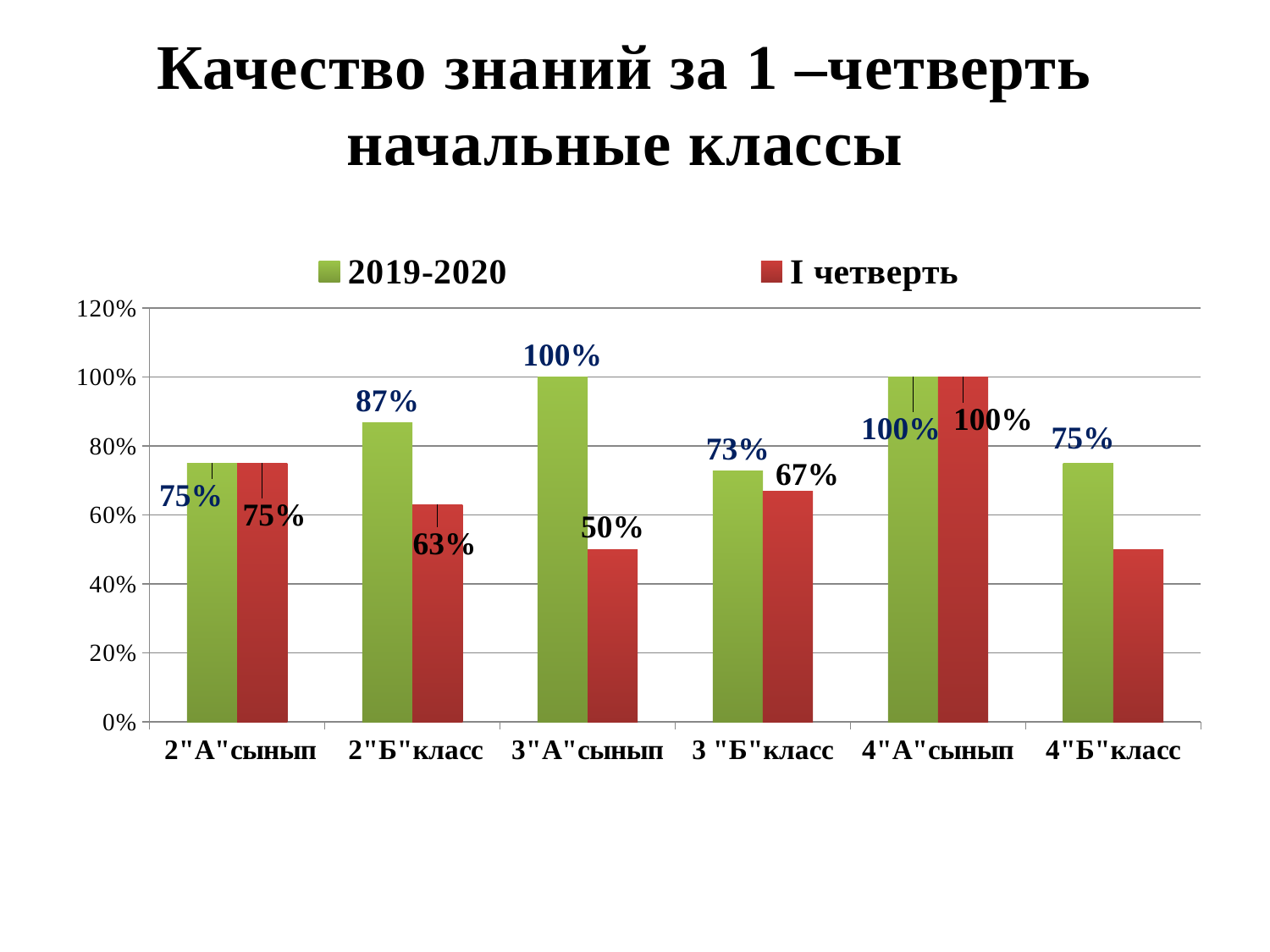
Is the I четверть value for 4"Б"класс greater or less than 60%? less Which class has the lowest 2019-2020 value? 3 "Б"класс Which is larger for 2"Б"класс: the 2019-2020 value or the I четверть value? 2019-2020 How many class categories are shown on the x axis? 6 Which class has the highest I четверть value? 4"А"сынып What colour are the bars for the I четверть series? red How many series does the legend list? 2 What is the 2019-2020 value for 2"Б"класс? 87% What is the difference between the 2019-2020 and I четверть values for 3"А"сынып? 50% What is the I четверть value for 3"А"сынып? 50% What is the I четверть value for 3 "Б"класс? 67% What kind of chart is shown on the slide? bar chart